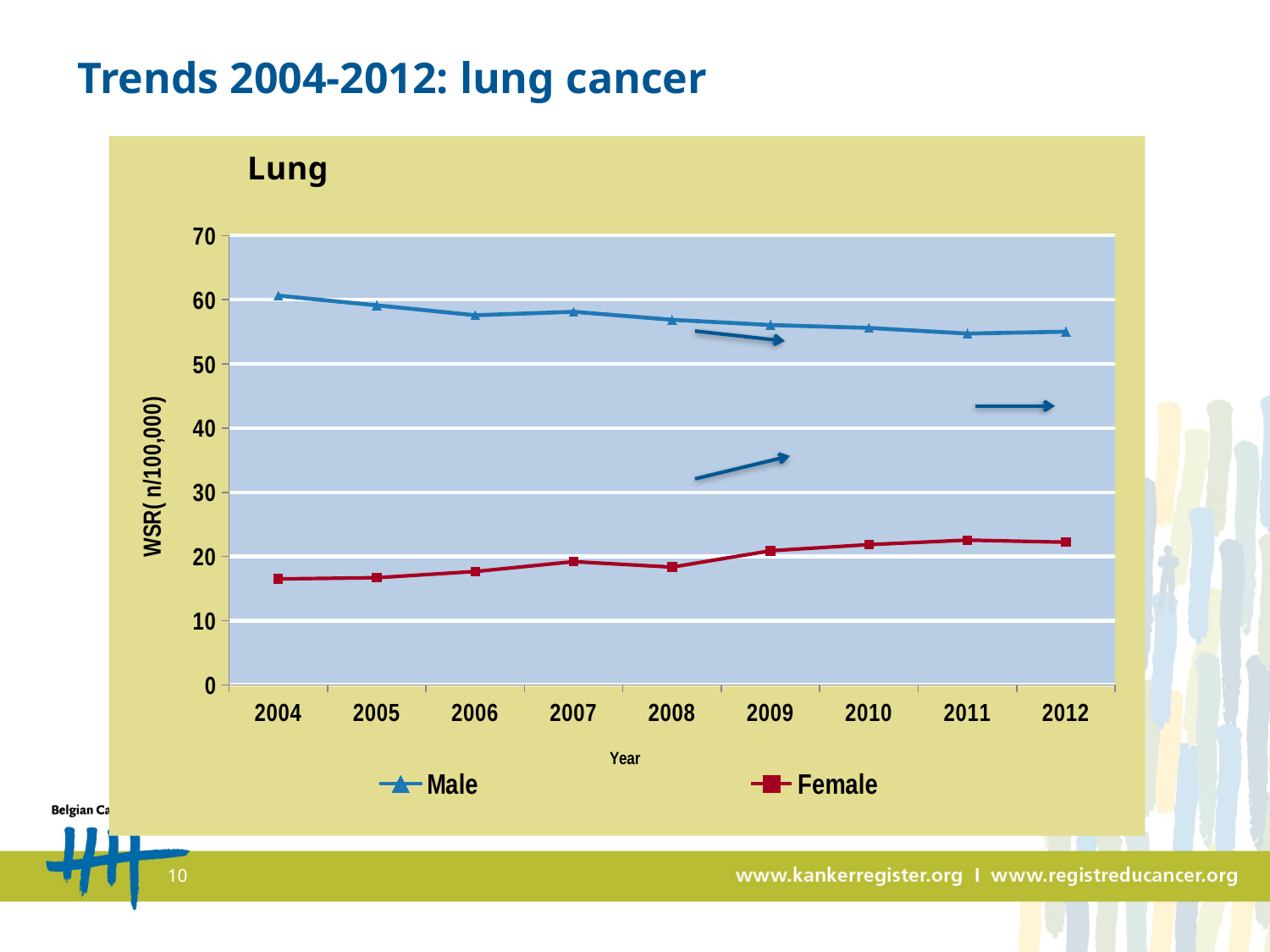
Does the Male series rise or fall from 2004 to 2012? fall In 2008, which series has the larger value, Male or Female? Male Is the Female value for 2004 greater or less than 20? less Is the Male value for 2012 greater or less than 60? less How many years are plotted along the x axis? 9 Is the Male value for 2004 greater or less than 50? greater Does the Female series rise or fall from 2004 to 2012? rise In which year is the Male series at its highest? 2004 What kind of chart is shown on the slide? line chart How many series does the legend list? 2 What is the label on the y axis of the chart? WSR( n/100,000)